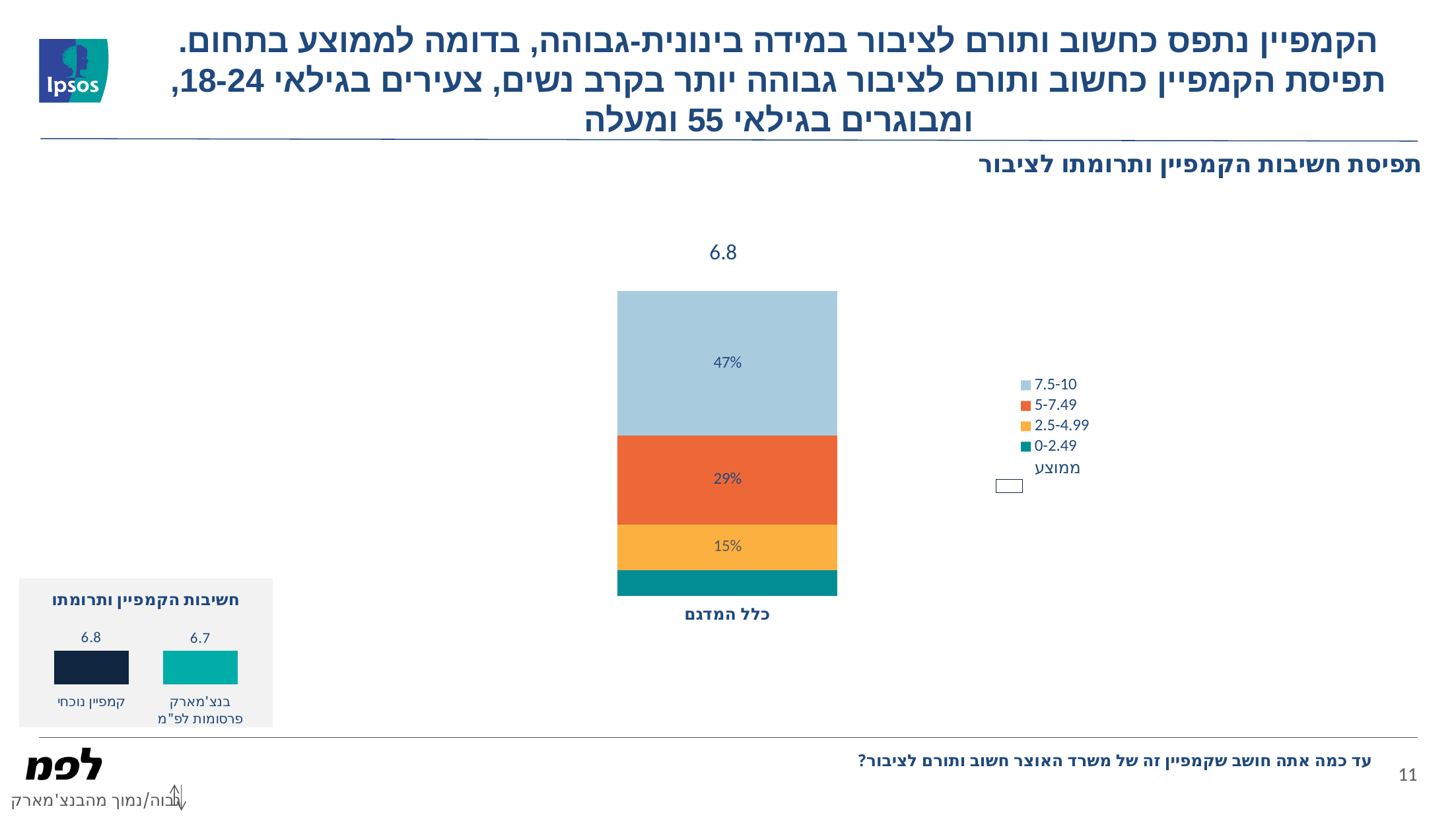
In the small chart at the bottom left (חשיבות הקמפיין ותרומתו), what is the value for קמפיין נוכחי? 6.8 How many entries does the legend of the main stacked bar chart list? 5 In the small chart at the bottom left, what is the value for בנצ'מארק פרסומות לפ"מ? 6.7 In the main stacked bar chart, what average value (ממוצע) is printed above the כלל המדגם bar? 6.8 In the main stacked bar chart, which is larger: the 5-7.49 segment or the 2.5-4.99 segment? 5-7.49 In the main stacked bar chart (תפיסת חשיבות הקמפיין ותרומתו לציבור), what percentage is shown for the 7.5-10 segment of כלל המדגם? 47% What kind of chart is the main chart in the centre of the slide? Stacked bar chart In the main stacked bar chart, which labelled segment has the largest share? 7.5-10 In the main stacked bar chart, what percentage is shown for the 2.5-4.99 segment? 15% In the small chart at the bottom left, how many bars are shown? 2 In the main stacked bar chart, what is the difference between the 7.5-10 segment and the 5-7.49 segment? 18% In the main stacked bar chart, what percentage is shown for the 5-7.49 segment? 29%